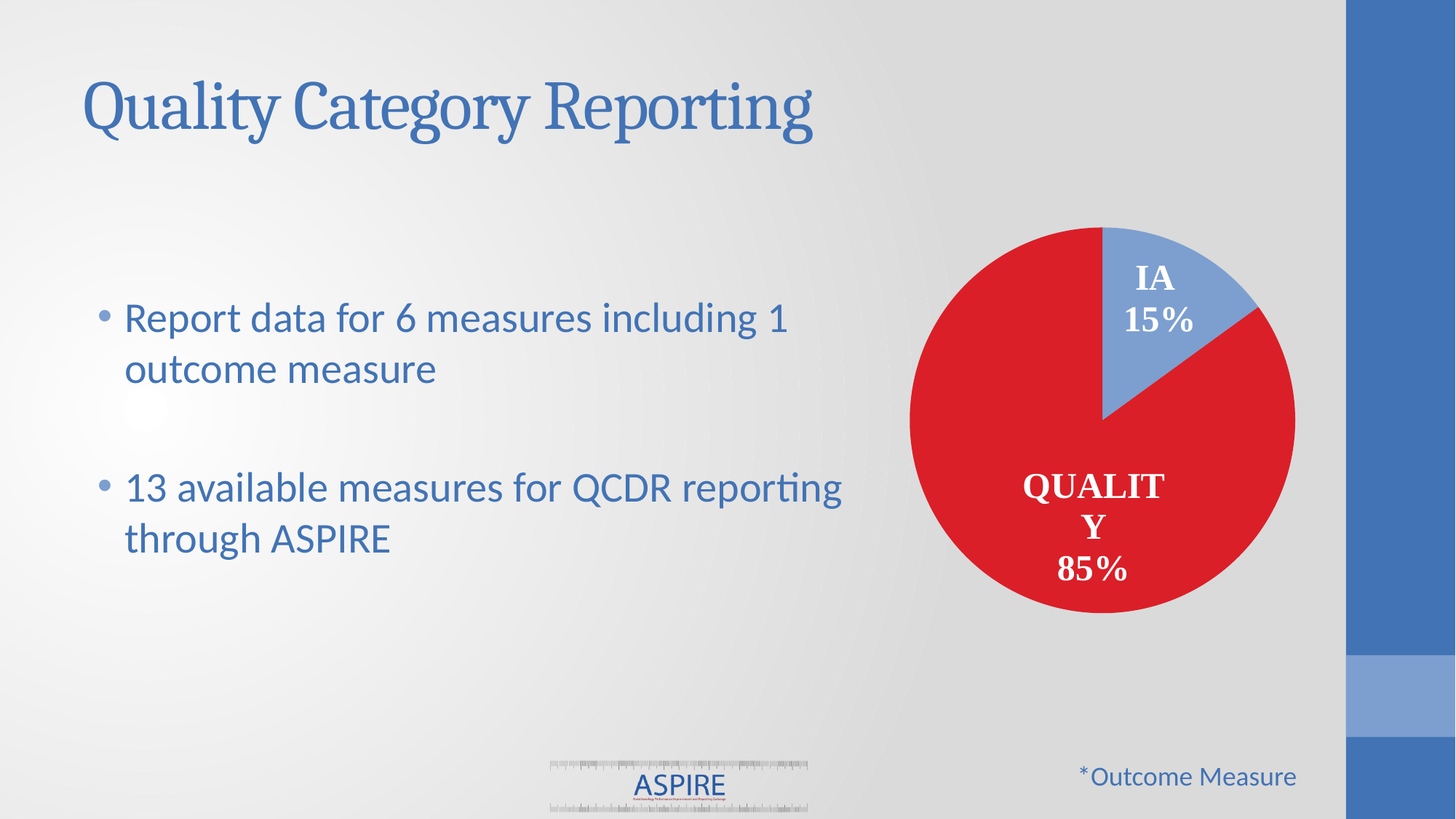
Which slice of the pie chart is the largest? QUALITY Is the share for IA greater or less than 50%? less What is the difference in percentage points between the QUALITY slice and the IA slice? 70 What colour is the QUALITY slice of the pie chart? red How many slices does the pie chart have? 2 What share of the pie does the IA slice represent? 15% Which slice is larger, QUALITY or IA? QUALITY What colour is the IA slice of the pie chart? blue Which slice of the pie chart is the smallest? IA What kind of chart is shown on the slide? pie chart What share of the pie does the QUALITY slice represent? 85%